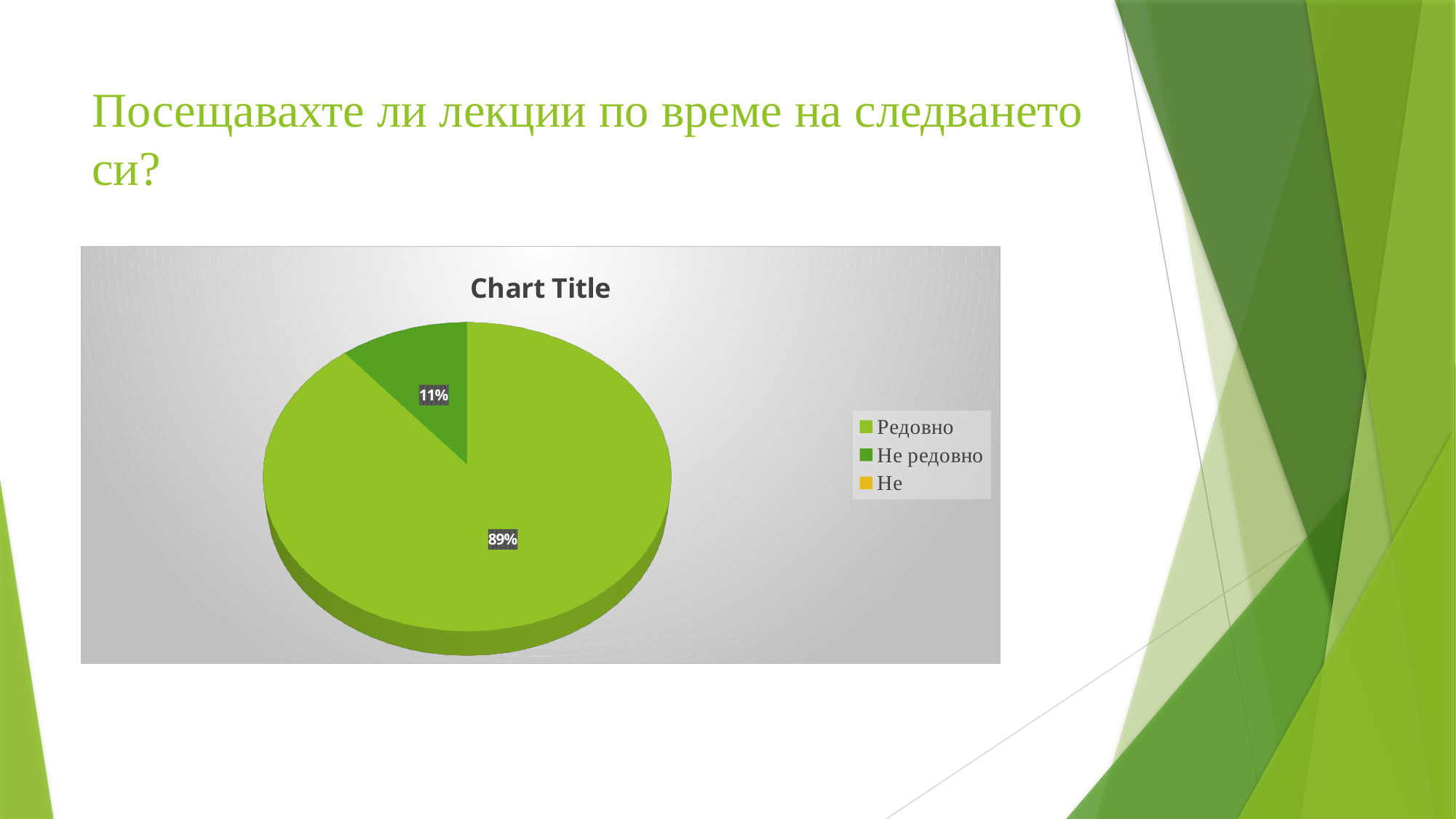
What percentage is shown for the Не редовно slice? 11% Which is larger, the Редовно slice or the Не редовно slice? Редовно How many slices have a percentage label printed on the pie? 2 Which of the two labelled slices is smaller, Редовно or Не редовно? Не редовно Which legend entry is shown with a yellow/orange colour marker? Не What share of the pie does the Редовно slice represent? 89% Which category has the largest slice of the pie? Редовно What is the title shown above the chart? Chart Title What percentage is shown for the Редовно slice? 89% What is the difference in percentage points between the Редовно and Не редовно slices? 78 How many entries does the legend list? 3 What type of chart is shown on the slide? pie chart